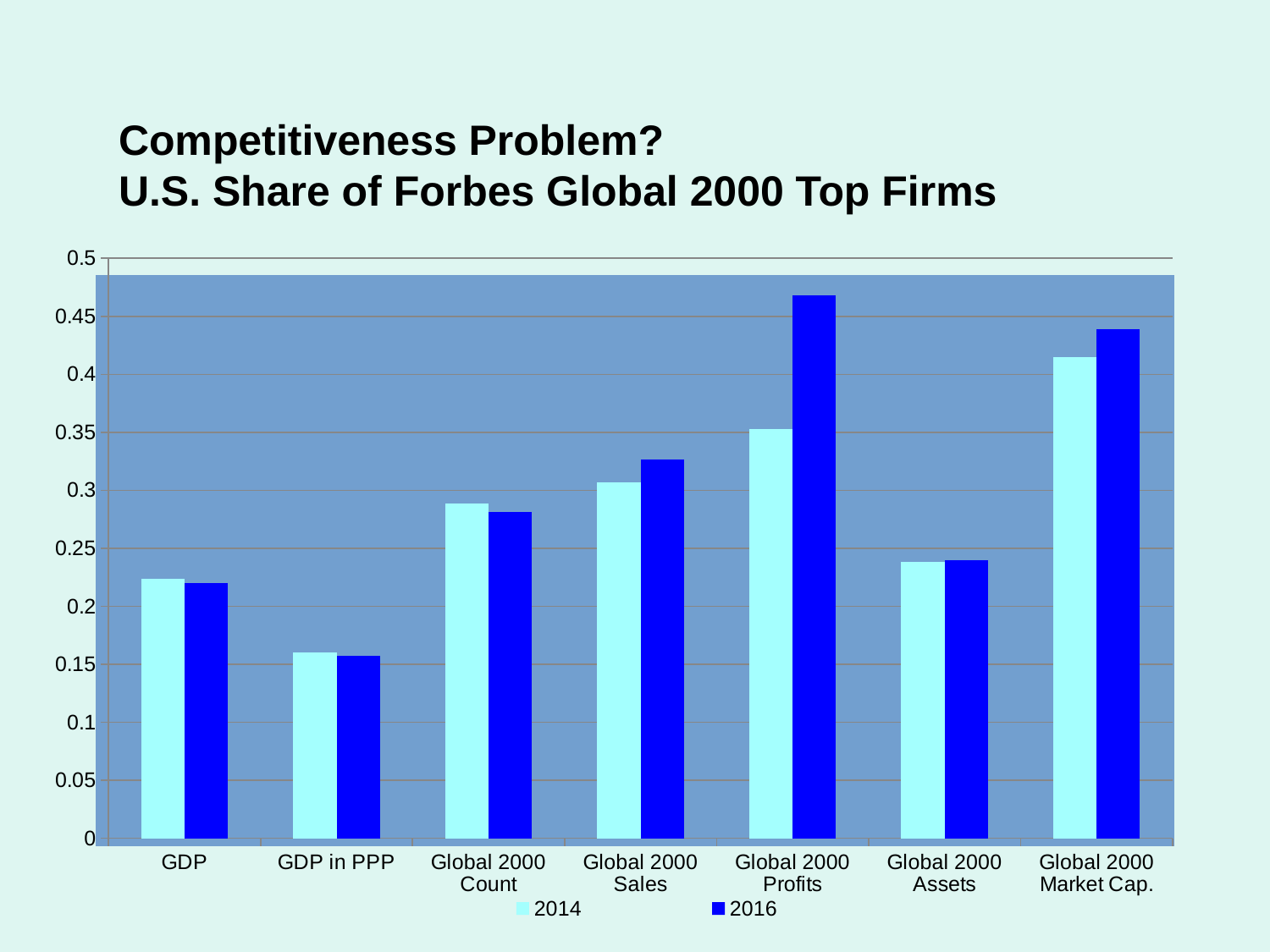
For Global 2000 Profits, which series has the larger value, 2014 or 2016? 2016 How many series does the legend list? 2 Is the 2014 value for GDP in PPP greater or less than 0.2? less Is the 2016 value for Global 2000 Profits greater or less than 0.45? greater Which category has the highest value for the 2014 series? Global 2000 Market Cap. How many categories are shown along the x axis? 7 Which category has the lowest value for the 2016 series? GDP in PPP For Global 2000 Market Cap., which series has the larger value, 2014 or 2016? 2016 Is the 2016 value for Global 2000 Sales greater or less than 0.3? greater Which category has the highest value for the 2016 series? Global 2000 Profits What kind of chart is shown on the slide? bar chart What are the two series listed in the legend? 2014 and 2016